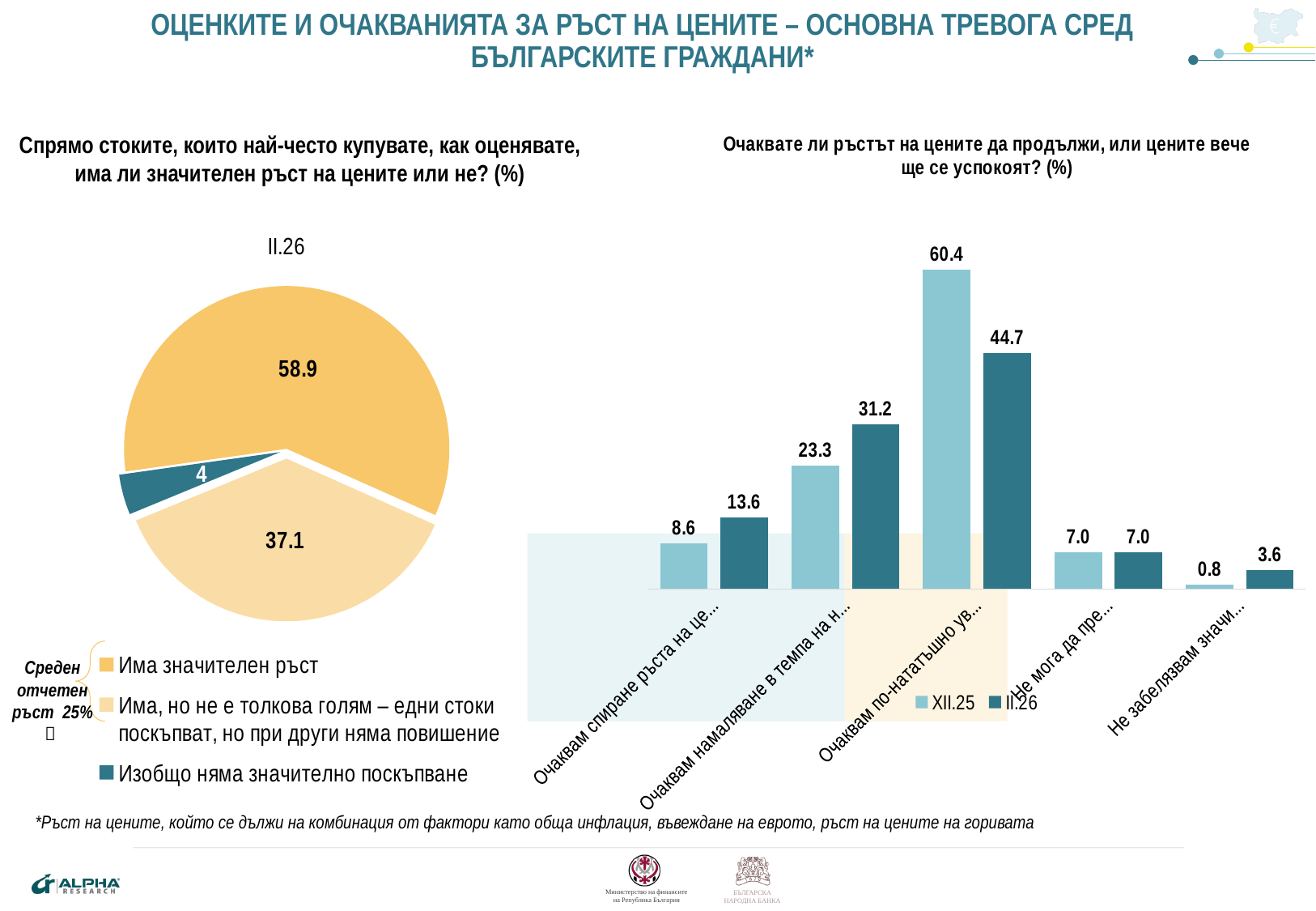
In the bar chart on the right, what is the II.26 value for the category beginning "Очаквам по-нататъшно ув..."? 44.7 In the bar chart on the right, which category has the highest XII.25 value? Очаквам по-нататъшно ув... In the bar chart on the right, what is the XII.25 value for the category beginning "Очаквам спиране ръста на це..."? 8.6 In the pie chart on the left, what share is shown for "Има значителен ръст"? 58.9 In the pie chart on the left, what value is shown for "Изобщо няма значително поскъпване"? 4 In the bar chart on the right, what is the difference between the XII.25 and II.26 values for the category beginning "Очаквам намаляване в темпа на н..."? 7.9 In the pie chart on the left, which category has the largest slice? Има значителен ръст In the pie chart on the left, what is the difference between the values for "Има значителен ръст" and "Има, но не е толкова голям"? 21.8 In the bar chart on the right, which category has the lowest II.26 value? Не забелязвам значи... In the pie chart on the left, how many slices does the pie have? 3 What type of chart is shown on the right side of the slide? Bar chart In the bar chart on the right, how many series does the legend list? 2